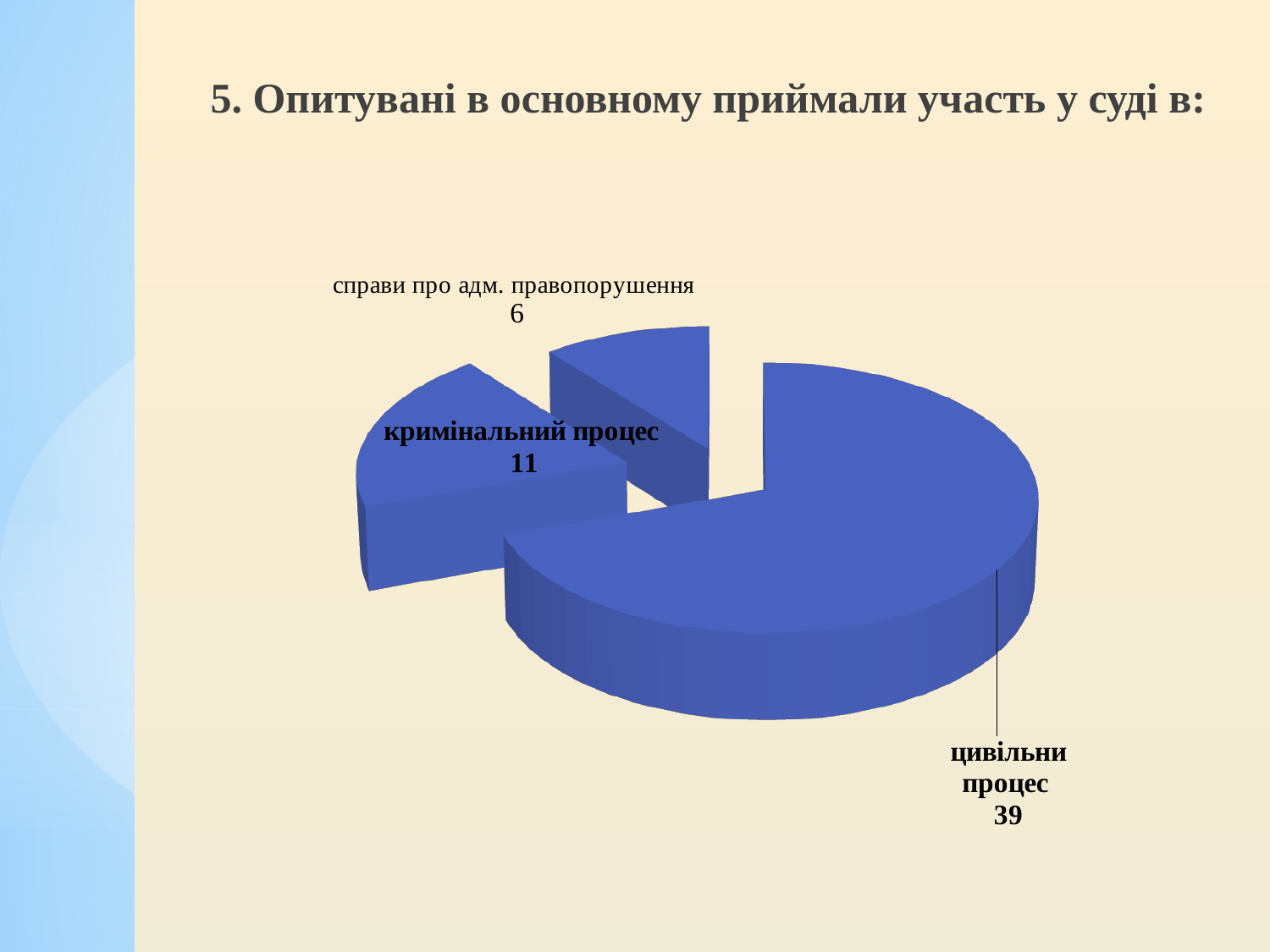
What is the value for "справи про адм. правопорушення"? 6 Which category has the smallest slice of the pie? справи про адм. правопорушення What is the value for "цивільни процес"? 39 What is the total of all the values shown in the pie chart? 56 How many categories (slices) does the pie chart have? 3 What is the difference between the values for "цивільни процес" and "кримінальний процес"? 28 What is the title of the slide containing the chart? 5. Опитувані в основному приймали участь у суді в: Which is larger, the value for "кримінальний процес" or the value for "справи про адм. правопорушення"? кримінальний процес What is the value for "кримінальний процес"? 11 Which category has the largest slice of the pie? цивільни процес What type of chart is shown on the slide? Pie chart What is the difference between the values for "кримінальний процес" and "справи про адм. правопорушення"? 5